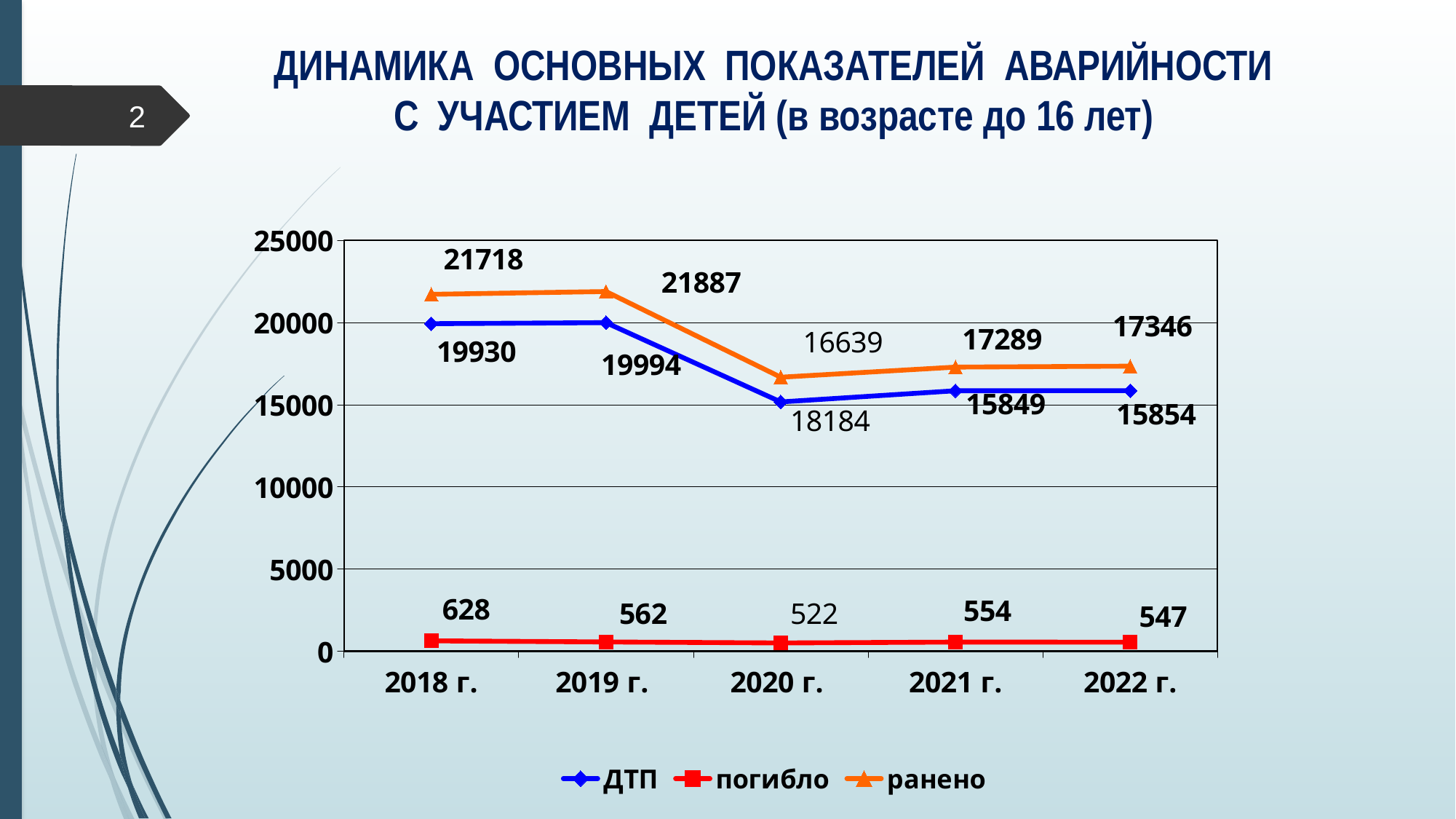
What kind of chart is shown on the slide? line chart What is the value of ранено in 2022 г.? 17346 Which year has the larger ранено value, 2018 г. or 2020 г.? 2018 г. What is the value of погибло in 2018 г.? 628 How many years are shown on the x axis? 5 Does the value of погибло rise or fall from 2018 г. to 2020 г.? fall How many series does the legend list? 3 By how much did погибло decrease from 2018 г. to 2022 г.? 81 In which year is the value of погибло lowest? 2020 г. What is the difference between the ранено values for 2019 г. and 2018 г.? 169 In which year is the value of ранено highest? 2019 г. What is the value of ДТП in 2018 г.? 19930